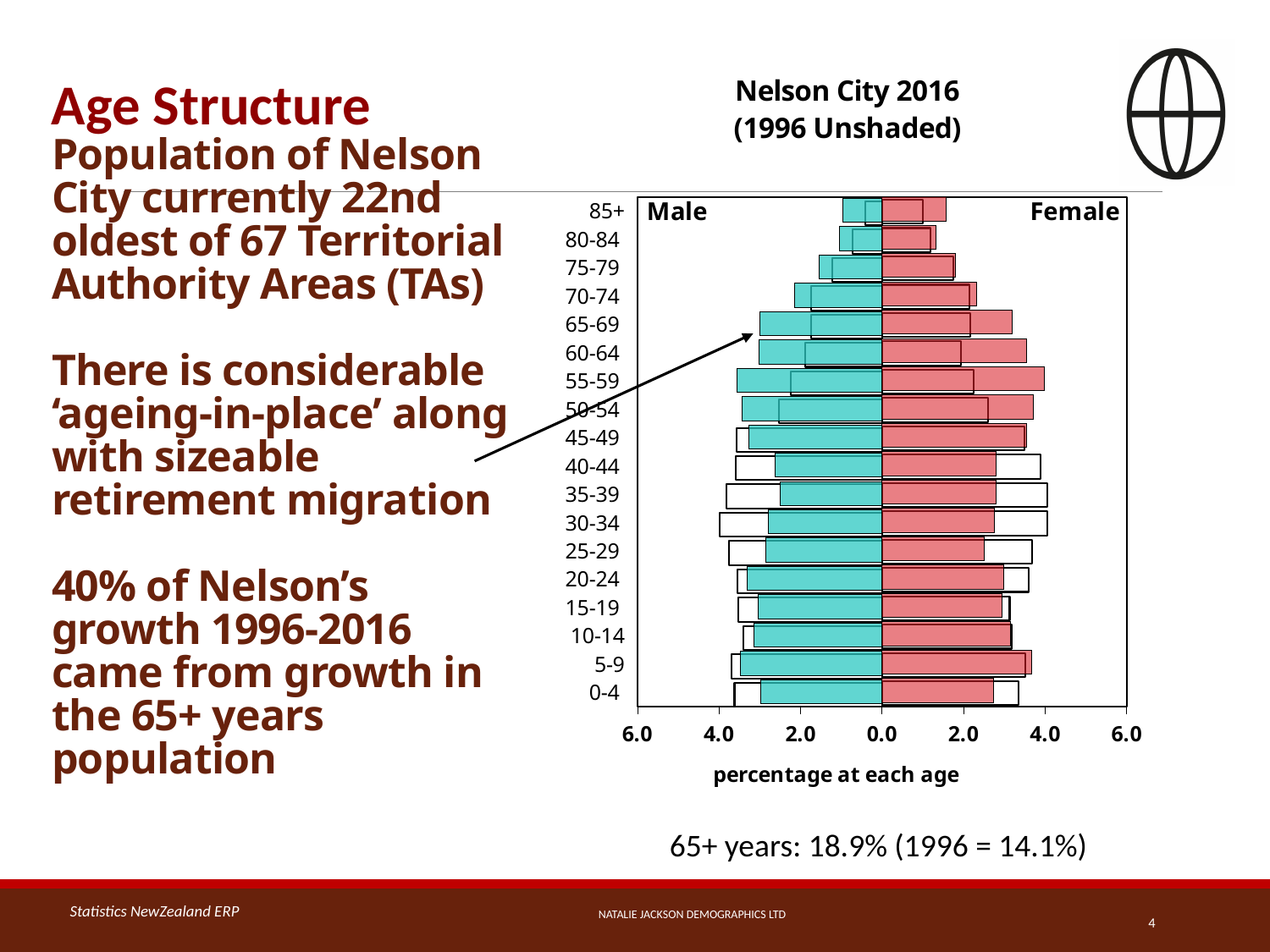
Is the shaded 2016 value for males aged 30-34 greater or less than 4.0? less What is the label on the horizontal axis of the chart? percentage at each age What is the title of the chart? Nelson City 2016 (1996 Unshaded) Is the shaded 2016 value for females aged 65-69 greater or less than 2.0? greater Is the shaded 2016 value for females aged 5-9 greater or less than 2.0? greater What kind of chart is shown on the slide? Bar chart (population pyramid) How many age groups are shown on the vertical axis of the chart? 18 Which is larger, the shaded 2016 value for males aged 75-79 or for males aged 55-59? Males aged 55-59 Which is larger, the shaded 2016 value for females aged 55-59 or for females aged 85+? Females aged 55-59